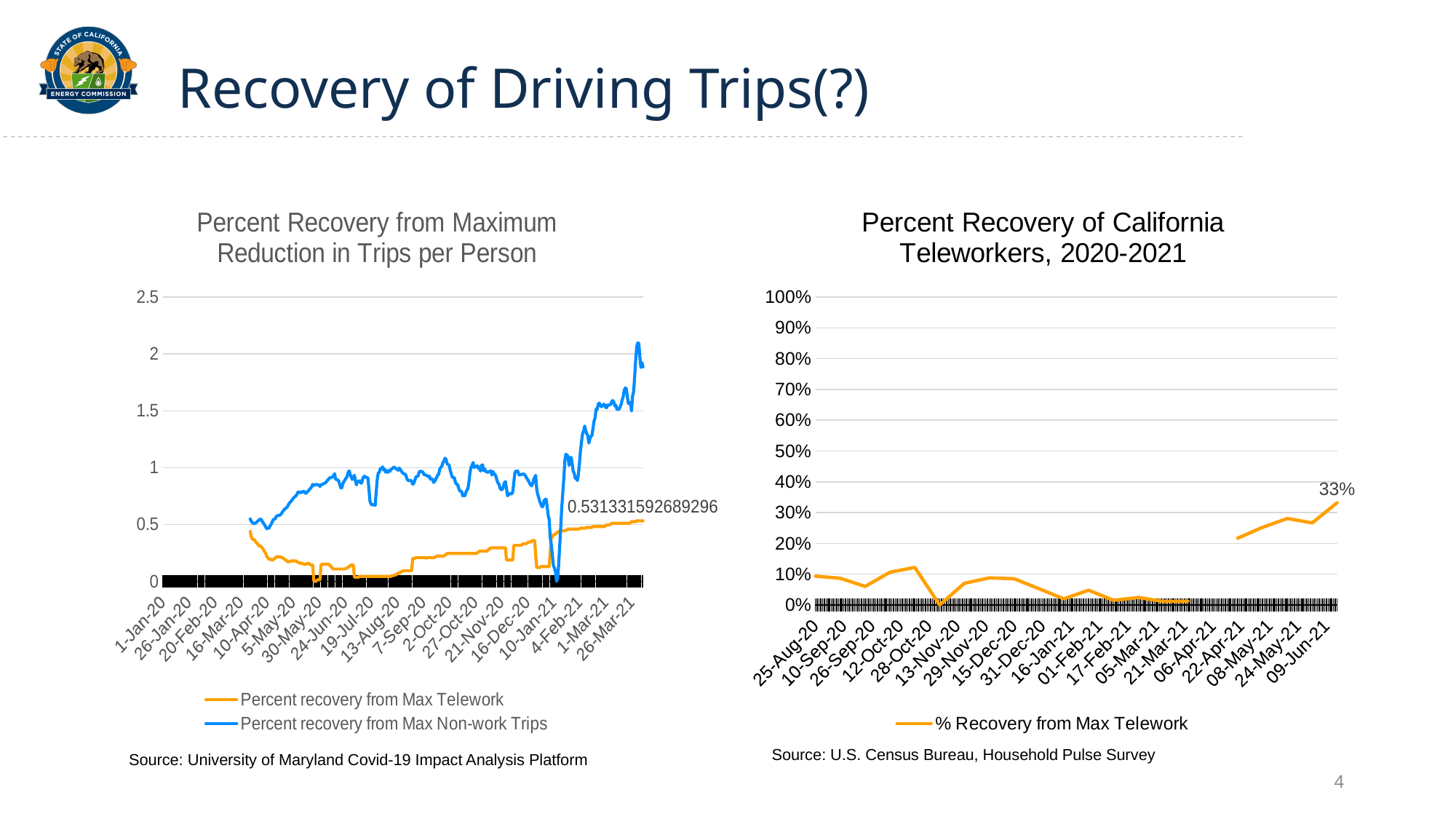
What is the legend entry of the 'Percent Recovery of California Teleworkers, 2020-2021' chart? % Recovery from Max Telework What kind of chart is the 'Percent Recovery of California Teleworkers, 2020-2021' chart? line chart In the 'Percent Recovery of California Teleworkers, 2020-2021' chart, what is the labelled value at the end of the line? 33% How many series does the legend of the 'Percent Recovery from Maximum Reduction in Trips per Person' chart list? 2 In the 'Percent Recovery from Maximum Reduction in Trips per Person' chart, which series reaches the higher value at the end of the period, 'Percent recovery from Max Telework' or 'Percent recovery from Max Non-work Trips'? Percent recovery from Max Non-work Trips In the 'Percent Recovery from Maximum Reduction in Trips per Person' chart, is the peak value of the 'Percent recovery from Max Non-work Trips' series greater or less than 2? greater In the 'Percent Recovery of California Teleworkers, 2020-2021' chart, does the line rise or fall between 22-Apr-21 and 09-Jun-21? rise In the 'Percent Recovery from Maximum Reduction in Trips per Person' chart, what is the final labelled value of the 'Percent recovery from Max Telework' series? 0.531331592689296 How many series does the legend of the 'Percent Recovery of California Teleworkers, 2020-2021' chart list? 1 What kind of chart is the 'Percent Recovery from Maximum Reduction in Trips per Person' chart? line chart In the 'Percent Recovery from Maximum Reduction in Trips per Person' chart, what colour is the 'Percent recovery from Max Non-work Trips' line? blue